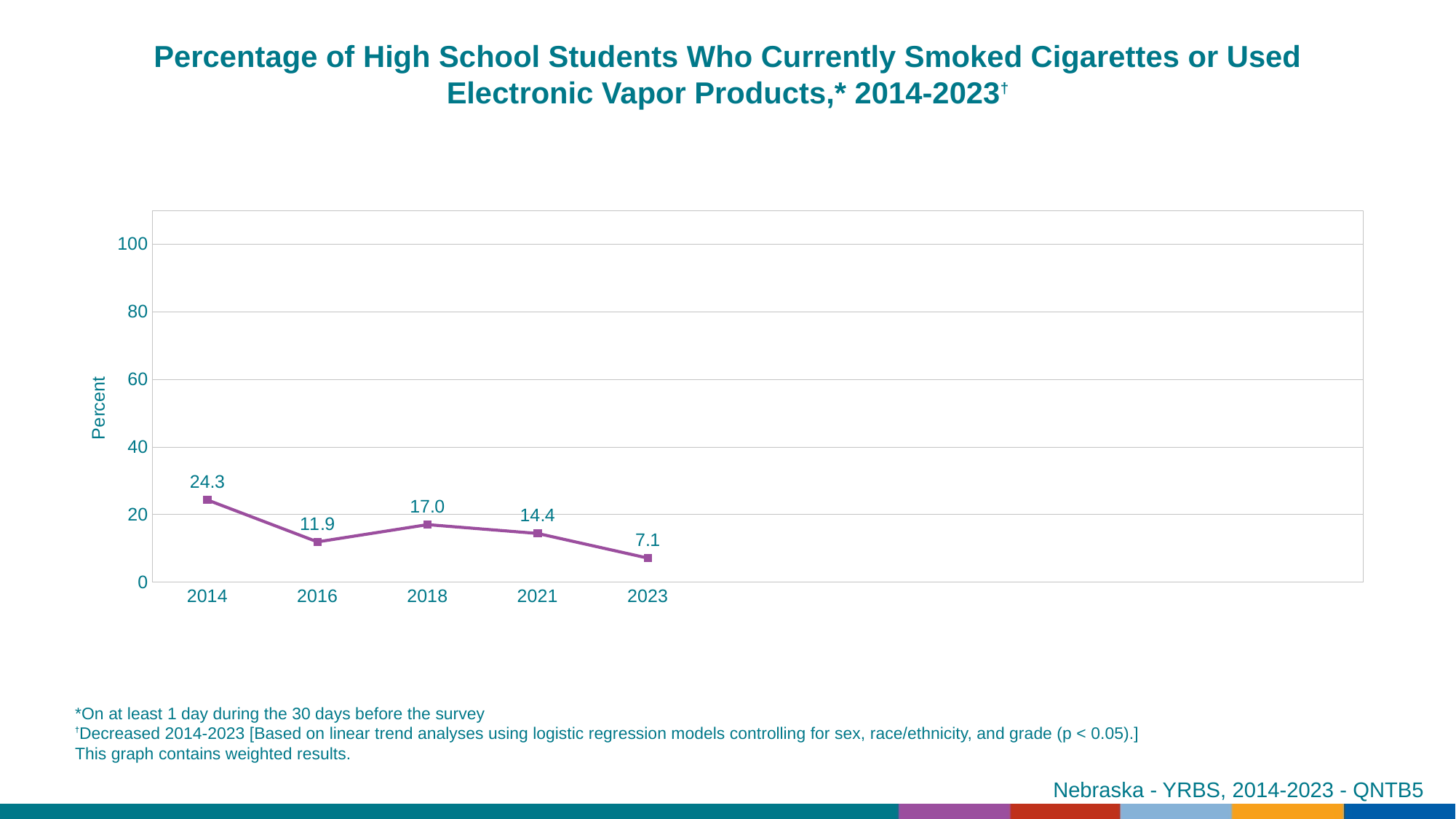
Which year has the highest value? 2014 What is the value for 2014? 24.3 How many years are plotted on the chart? 5 What is the difference between the values for 2014 and 2023? 17.2 Which is larger, the value for 2016 or the value for 2018? 2018 What is the value for 2018? 17.0 Is the value for 2021 greater or less than 20? less Do the values generally rise or fall from 2014 to 2023? fall What is the label on the y axis? Percent Which year has the lowest value? 2023 What is the value for 2023? 7.1 What kind of chart is shown? line chart